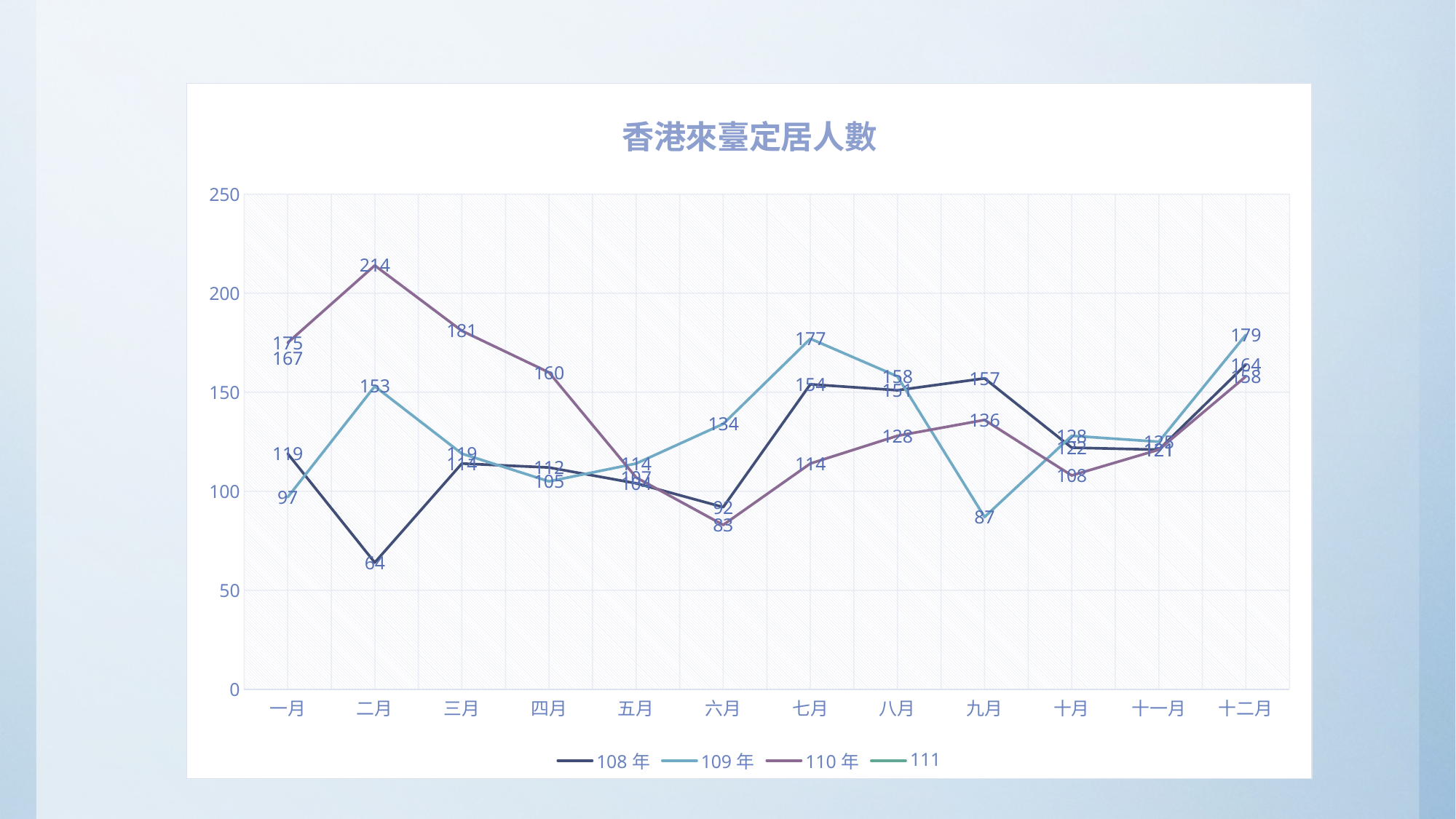
In which month does the 108 年 series have its lowest value? 二月 How many series does the legend list? 4 How many months are shown on the x axis? 12 What is the difference between the 109 年 and 108 年 values in 十二月? 15 What is the value for 110 年 in 二月? 214 Which series has the larger value in 七月, 108 年 or 109 年? 109 年 What is the value for 109 年 in 七月? 177 What is the value for 109 年 in 九月? 87 What type of chart is shown on the slide? line chart What is the title of the chart? 香港來臺定居人數 What is the value for 108 年 in 二月? 64 In which month does the 110 年 series reach its highest value? 二月